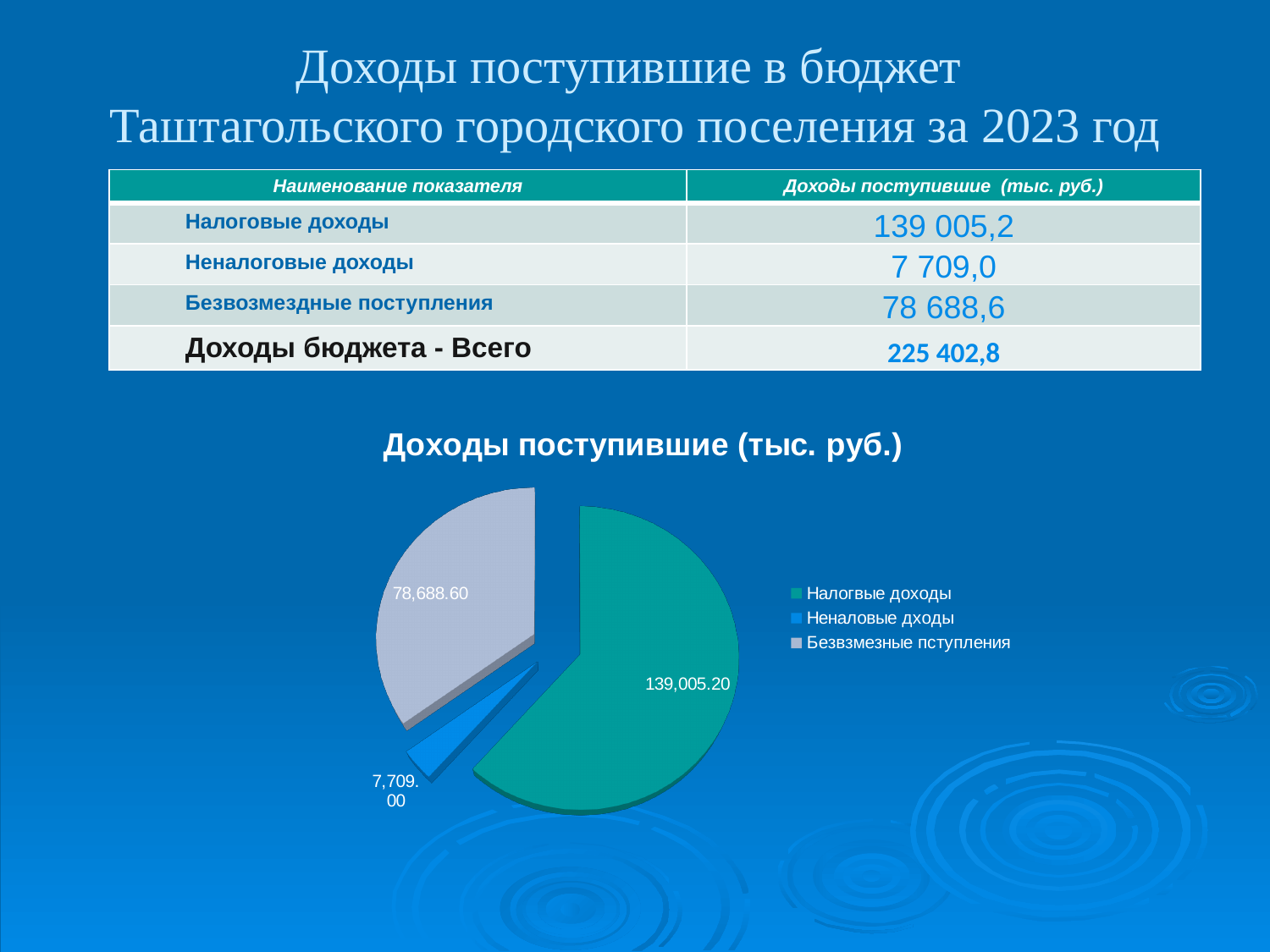
What value is shown on the pie chart for Неналоговые доходы? 7,709.00 Which slice of the pie chart is the largest? Налоговые доходы Which is larger in the pie chart: Безвозмездные поступления or Неналоговые доходы? Безвозмездные поступления What is the difference between the Налоговые доходы and Безвозмездные поступления values in the pie chart? 60,316.60 How many entries does the chart legend list? 3 Which slice of the pie chart is the smallest? Неналоговые доходы What colour is the Налоговые доходы slice in the pie chart? green What value is shown on the pie chart for Безвозмездные поступления? 78,688.60 How many slices does the pie chart have? 3 What is the title of the chart? Доходы поступившие (тыс. руб.) What value is shown on the pie chart for Налоговые доходы? 139,005.20 What type of chart is shown on the slide? pie chart